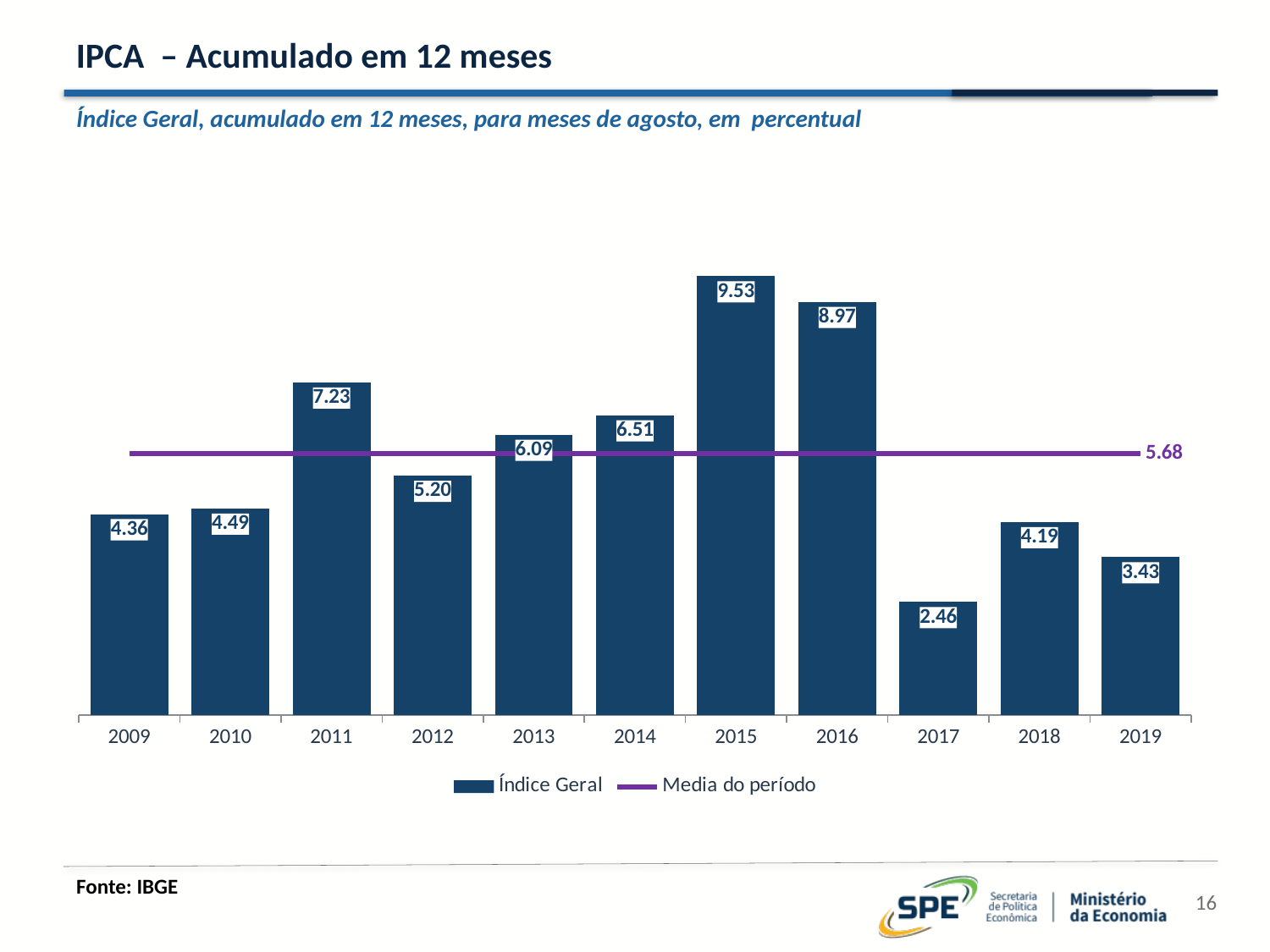
Which year has the lowest value? 2017 What is the value for 2015? 9.53 Which year has the highest value? 2015 What is the value of the 'Media do período' line? 5.68 What kind of chart is shown? Bar chart with a line How many series does the legend list? 2 How many years are shown on the x axis? 11 What is the difference between the values for 2015 and 2016? 0.56 What is the difference between the values for 2011 and 2012? 2.03 Do the values rise or fall from 2016 to 2017? Fall What is the value for 2017? 2.46 Which is larger, the value for 2013 or the value for 2014? 2014